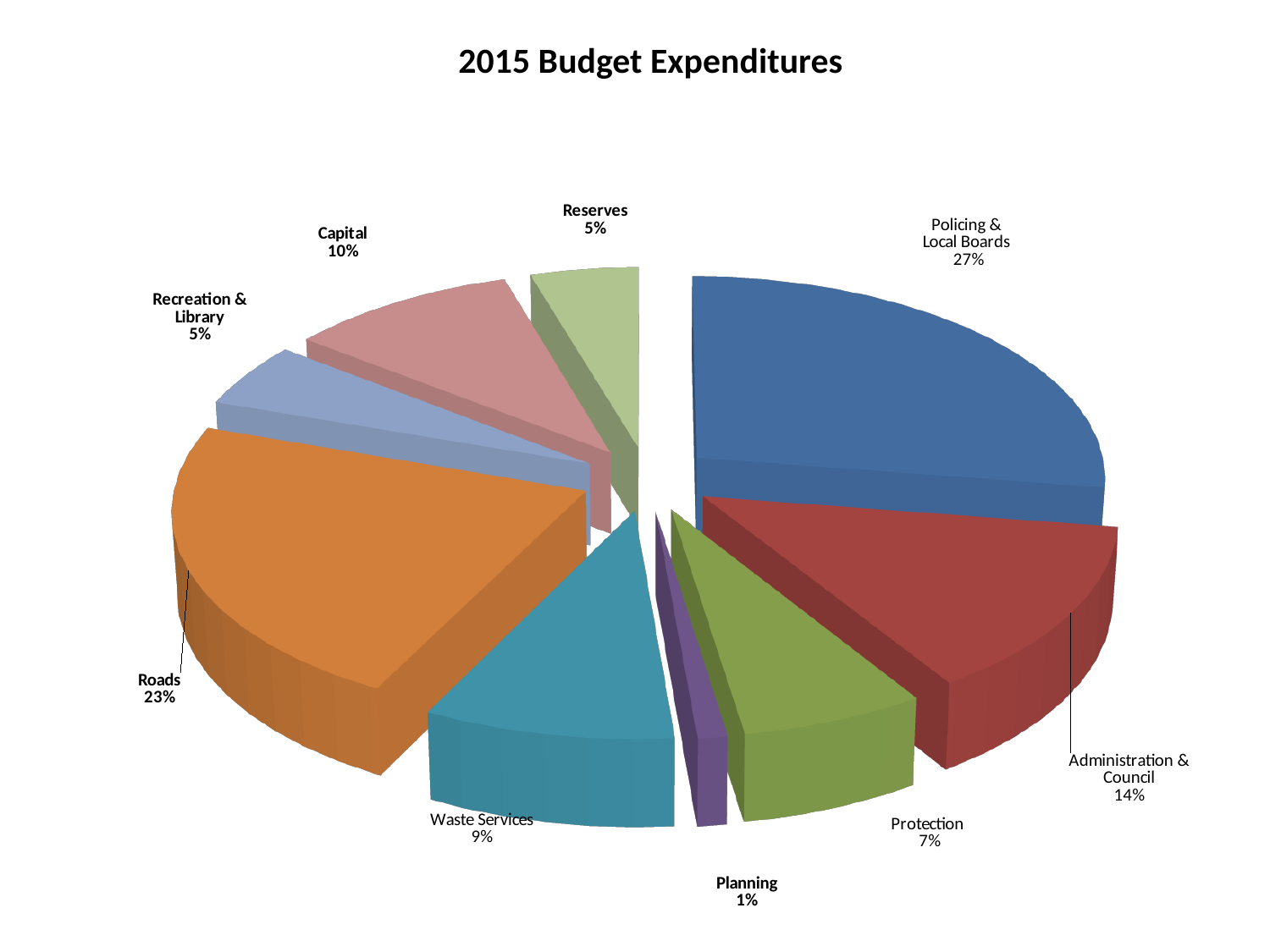
What kind of chart is shown on the slide? Pie chart What percentage is shown for Waste Services? 9% What percentage is shown for Roads? 23% How many categories are shown in the pie chart? 9 Which category has the largest slice of the pie? Policing & Local Boards What share of the 2015 Budget Expenditures pie is Policing & Local Boards? 27% Which category has the smallest slice of the pie? Planning What is the difference in percentage points between Policing & Local Boards and Roads? 4 What is the title of the chart? 2015 Budget Expenditures Which is larger, Capital or Protection? Capital What is the combined percentage of Reserves and Recreation & Library? 10% What percentage is shown for Administration & Council? 14%